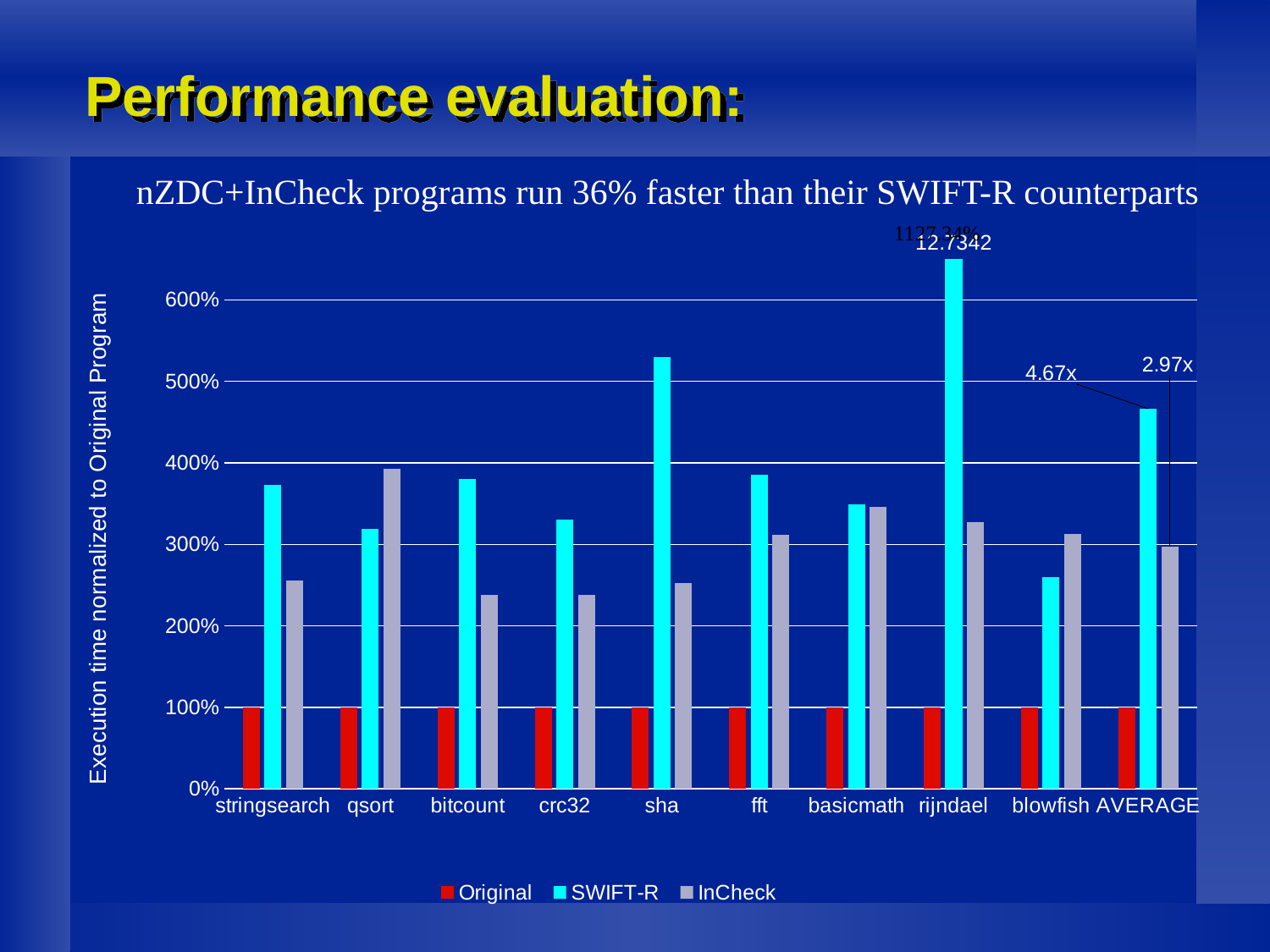
What is the title of the y axis? Execution time normalized to Original Program For qsort, which is larger: the SWIFT-R bar or the InCheck bar? InCheck What is the value of the Original bar for stringsearch? 100% What label is printed above the InCheck bar for AVERAGE? 2.97x Which category has the lowest SWIFT-R bar? blowfish What kind of chart is shown on the slide? bar chart Which category has the highest SWIFT-R bar? rijndael How many categories are shown along the x axis? 10 Is the SWIFT-R value for sha greater or less than 500%? greater What label is printed above the SWIFT-R bar for AVERAGE? 4.67x Is the InCheck value for stringsearch greater or less than 300%? less How many series does the legend list? 3